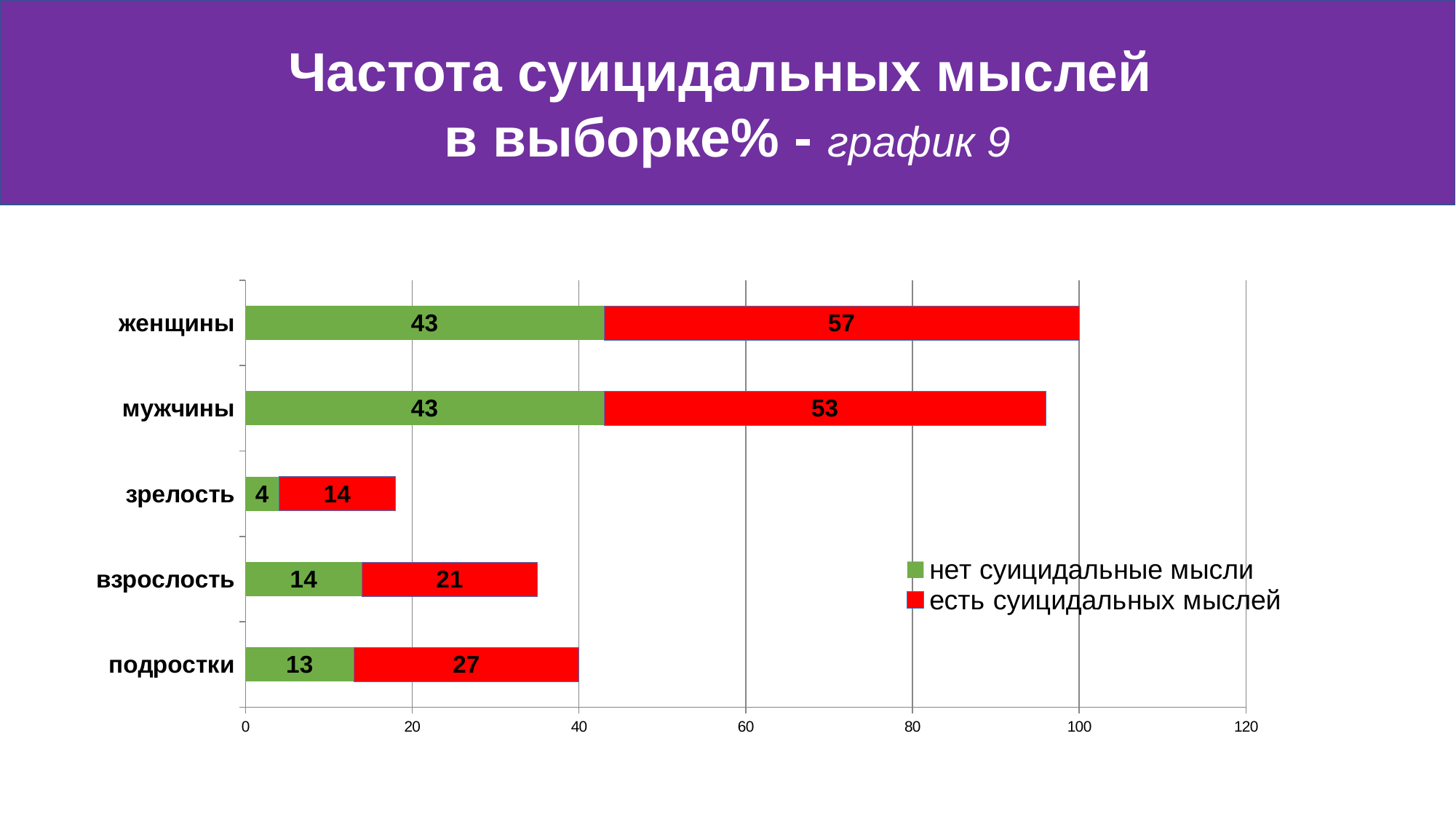
Which is larger: the 'есть суицидальных мыслей' value for подростки or for взрослость? подростки Which category has the lowest value for 'нет суицидальные мысли'? зрелость How many series does the legend list? 2 What is the value of 'нет суицидальные мысли' for подростки? 13 What is the difference between the 'есть суицидальных мыслей' values for женщины and мужчины? 4 What is the value of 'есть суицидальных мыслей' for взрослость? 21 What kind of chart is shown on the slide? Stacked bar chart What is the total of the stacked bar for мужчины? 96 What is the total of the stacked bar for зрелость? 18 Which category has the highest value for 'есть суицидальных мыслей'? женщины How many categories are shown on the chart? 5 What is the value of 'есть суицидальных мыслей' for женщины? 57